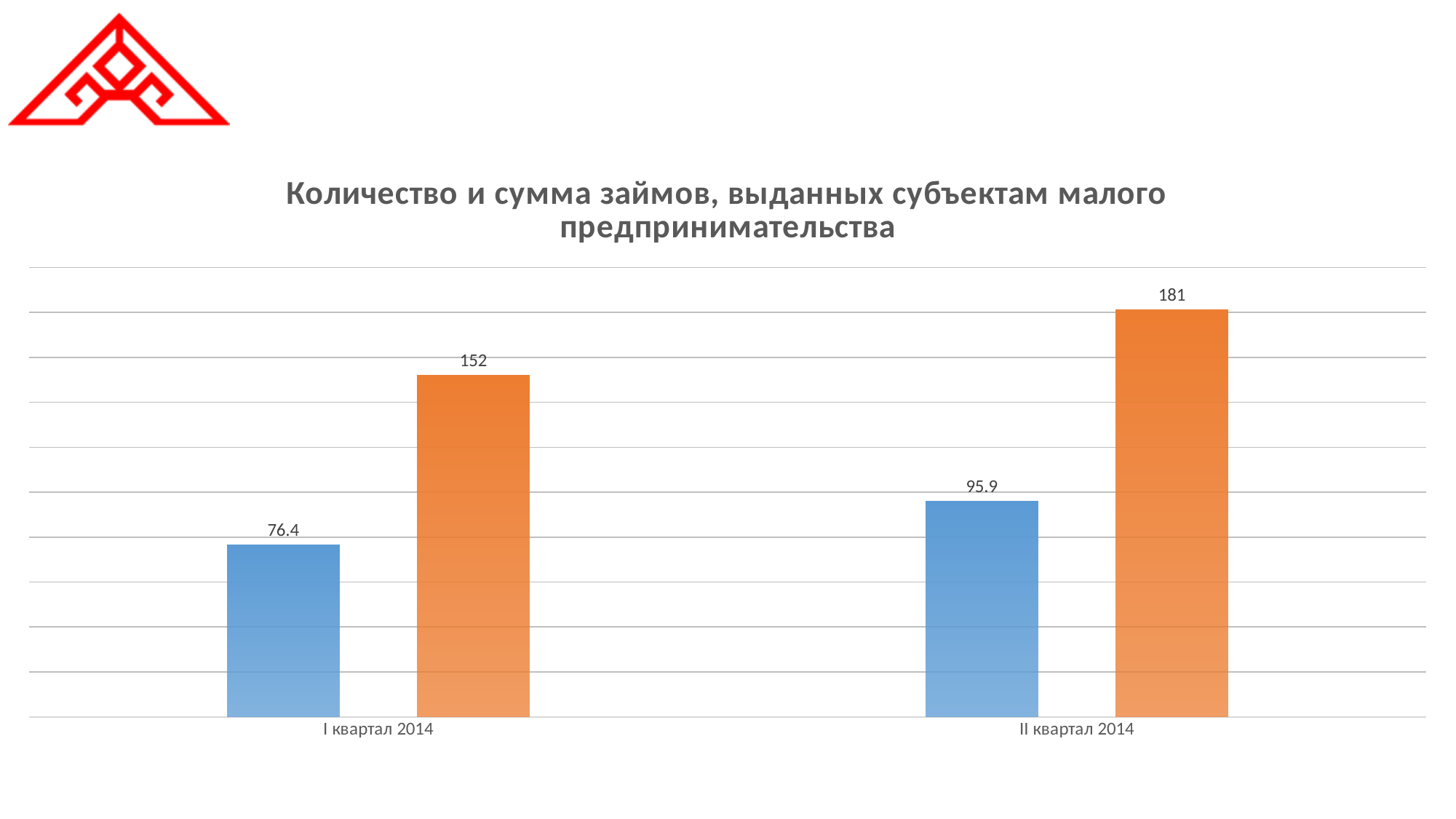
What is the value of the blue bar for II квартал 2014? 95.9 What is the difference between the blue bar values for II квартал 2014 and I квартал 2014? 19.5 Which category has the lowest blue bar? I квартал 2014 Which category has the highest orange bar? II квартал 2014 Do the orange bar values rise or fall from I квартал 2014 to II квартал 2014? rise What is the difference between the orange bar values for II квартал 2014 and I квартал 2014? 29 What is the value of the orange bar for II квартал 2014? 181 Which is larger: the blue bar for II квартал 2014 or the orange bar for I квартал 2014? the orange bar for I квартал 2014 How many categories are shown on the x axis? 2 What is the value of the blue bar for I квартал 2014? 76.4 What is the value of the orange bar for I квартал 2014? 152 What kind of chart is shown on the slide? bar chart